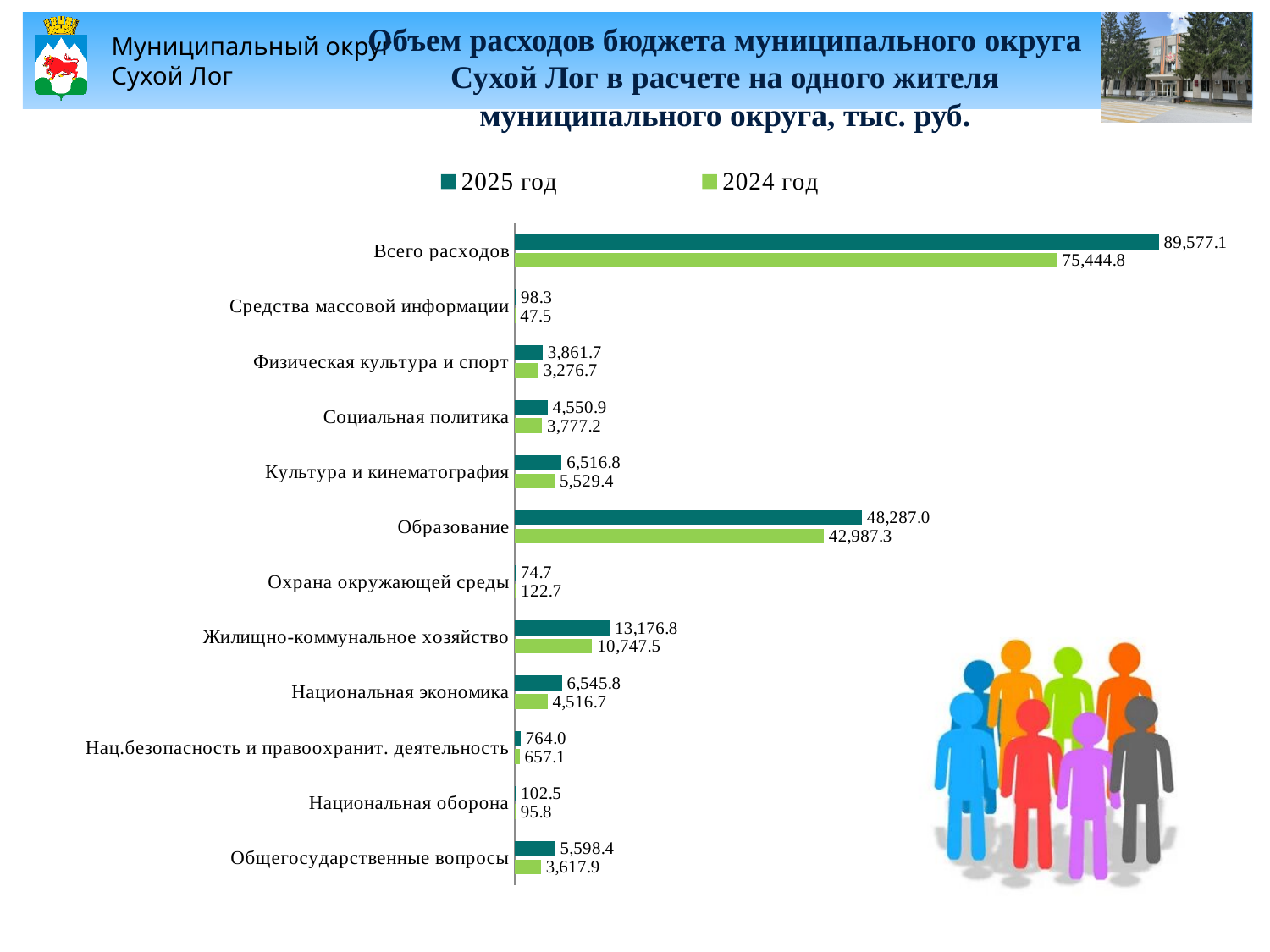
Which category has the lowest value in 2024 год? Средства массовой информации What is the value for Всего расходов in 2024 год? 75,444.8 How many series does the legend list? 2 What are the two entries in the chart legend? 2025 год and 2024 год What is the difference between the 2025 год and 2024 год values for Всего расходов? 14,132.3 What kind of chart is shown on the slide? bar chart For Охрана окружающей среды, which year has the larger value, 2025 год or 2024 год? 2024 год What is the value for Образование in 2025 год? 48,287.0 Excluding Всего расходов, which category has the highest value in 2025 год? Образование What is the value for Жилищно-коммунальное хозяйство in 2024 год? 10,747.5 How many categories are plotted on the chart? 12 Which category has the lowest value in 2025 год? Охрана окружающей среды